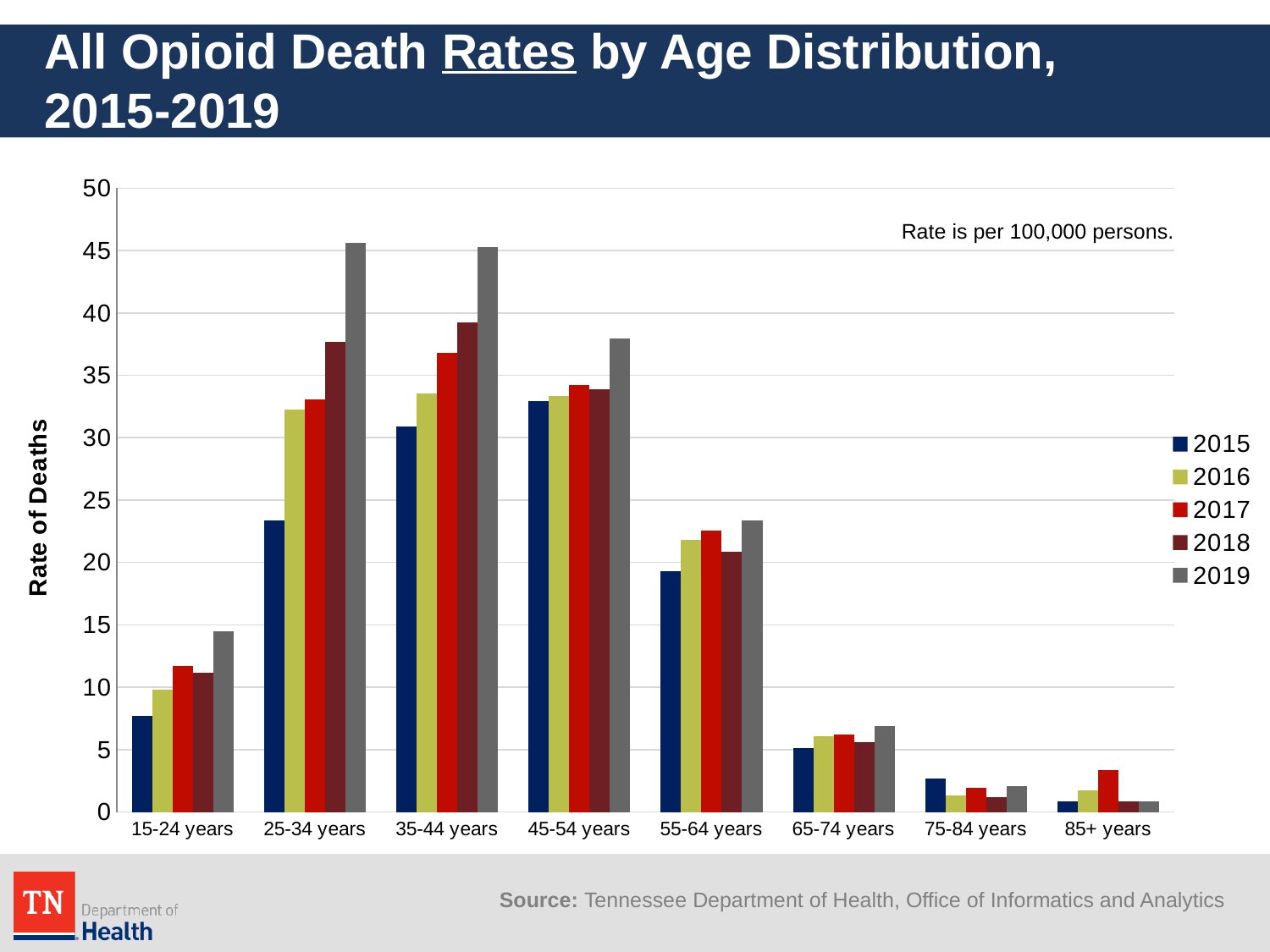
Is the 2019 value for 25-34 years greater or less than 40? greater In the 35-44 years group, do the rates rise or fall from 2015 to 2019? rise Which is larger, the 2015 rate for 25-34 years or the 2015 rate for 35-44 years? 35-44 years How many age groups are shown on the x axis? 8 What kind of chart is shown on the slide? bar chart Which age group has the lowest 2015 rate? 85+ years How many series does the legend list? 5 Within the 25-34 years group, which year has the highest rate? 2019 Which is larger, the 2017 rate for 75-84 years or the 2017 rate for 85+ years? 85+ years Is the 2019 value for 55-64 years greater or less than 20? greater Is the 2015 value for 15-24 years greater or less than 10? less What is the title of the y axis? Rate of Deaths